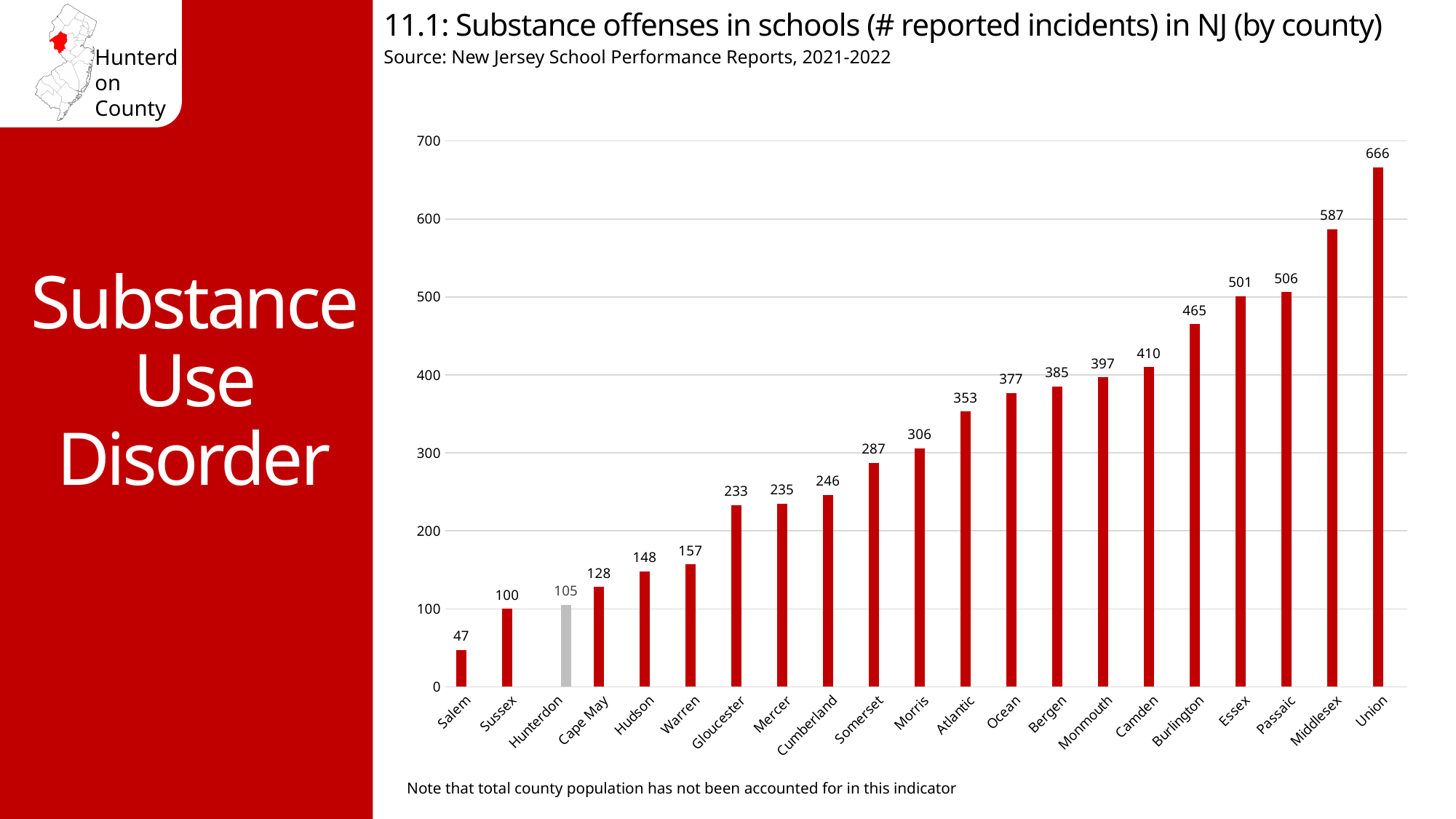
Is the value for Burlington greater or less than 400? greater What kind of chart is used on this slide? Bar chart What is the value shown for Middlesex County? 587 Do the values rise or fall moving from left to right along the x axis? Rise How many counties are shown on the chart? 21 How many more incidents does Essex have than Hunterdon? 396 What is the difference between the values for Union and Salem? 619 Which county has the lowest number of reported incidents? Salem What is the number of reported substance offense incidents in schools for Hunterdon County? 105 Which county's bar is coloured grey instead of red? Hunterdon Which has a higher value, Gloucester or Somerset? Somerset Which county has the highest number of reported incidents? Union